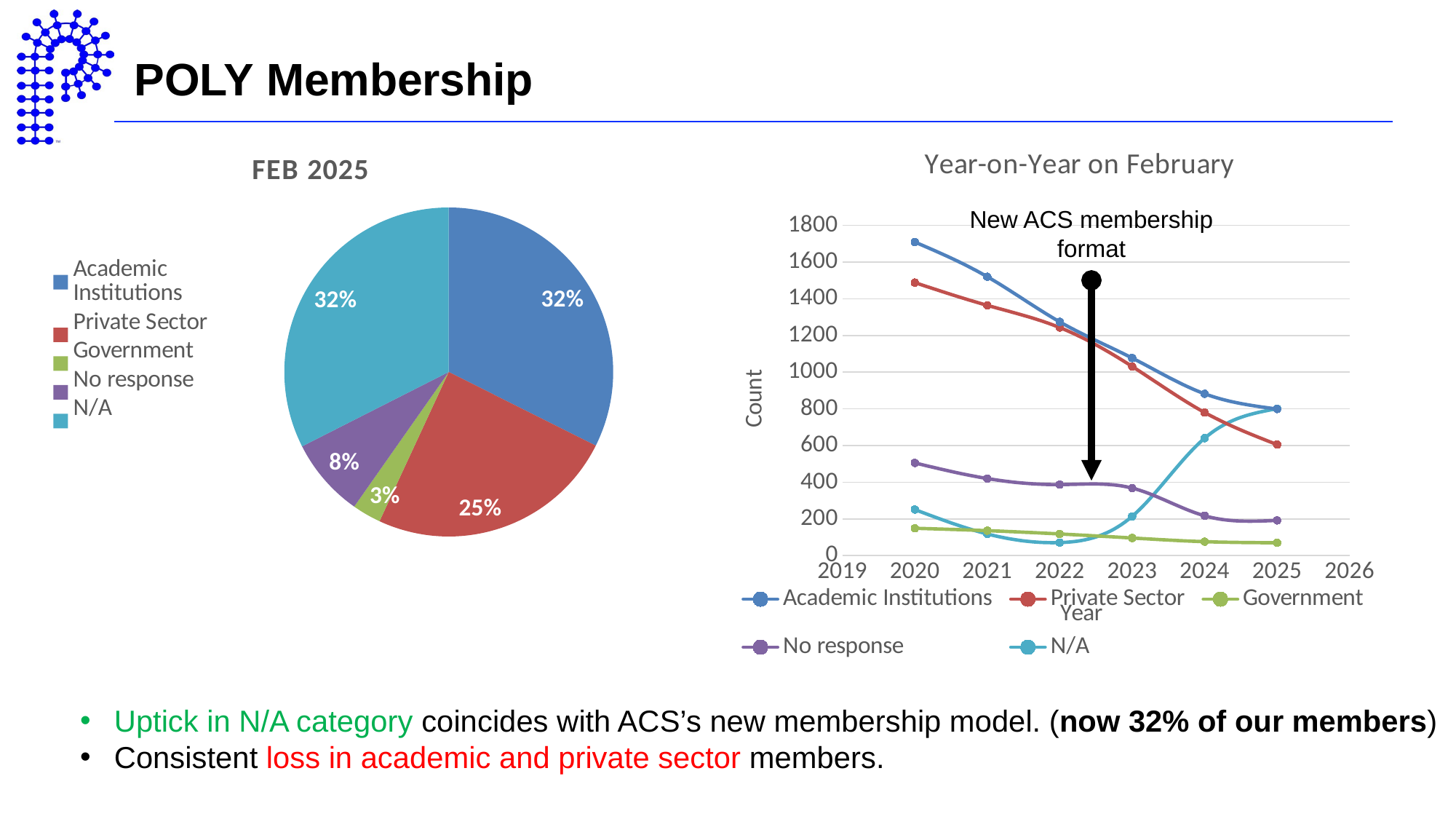
How many series does the legend of the Year-on-Year on February chart list? 5 In the Year-on-Year on February chart, do the Academic Institutions values rise or fall from 2020 to 2025? fall In the FEB 2025 pie chart, what share is Private Sector? 25% In the FEB 2025 pie chart, what is the difference between the Private Sector share and the No response share? 17% What kind of chart is the Year-on-Year on February chart? Line chart In the FEB 2025 pie chart, which is larger, Private Sector or No response? Private Sector How many slices does the FEB 2025 pie chart have? 5 In the Year-on-Year on February chart, is the Government value for 2020 greater or less than 200? less What is the title of the line chart on the right of the slide? Year-on-Year on February In the Year-on-Year on February chart, is the Academic Institutions value for 2020 greater or less than 1600? greater In the FEB 2025 pie chart, which category has the smallest share? Government In the FEB 2025 pie chart, what share is No response? 8%